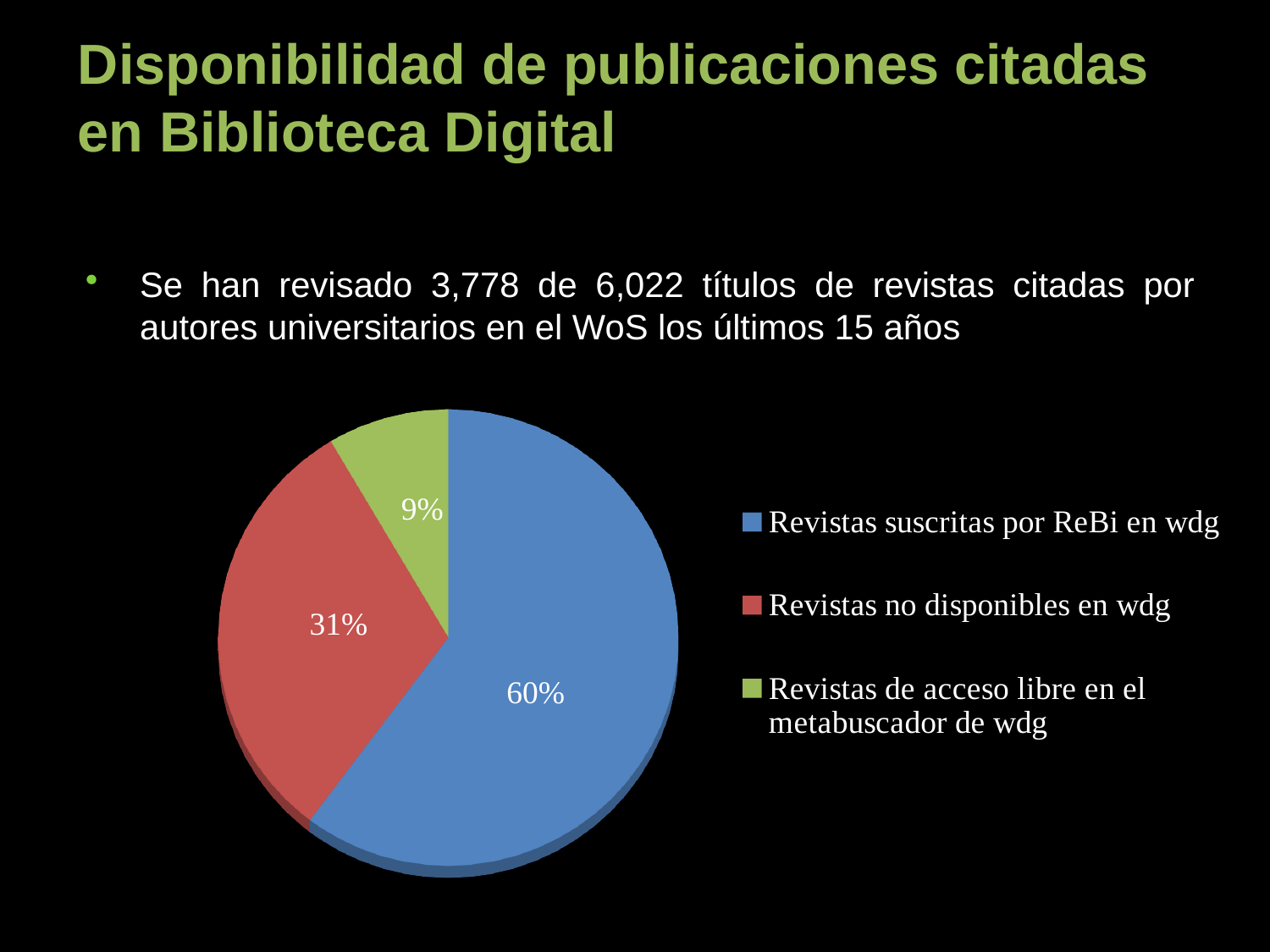
Which is larger: the slice for 'Revistas no disponibles en wdg' or the slice for 'Revistas de acceso libre en el metabuscador de wdg'? Revistas no disponibles en wdg What kind of chart is shown on the slide? Pie chart How many slices does the pie chart have? 3 Which category has the largest slice of the pie? Revistas suscritas por ReBi en wdg What share of the pie is 'Revistas no disponibles en wdg'? 31% What colour is the slice for 'Revistas no disponibles en wdg'? Red What is the difference in percentage points between 'Revistas no disponibles en wdg' and 'Revistas de acceso libre en el metabuscador de wdg'? 22 What share of the pie is 'Revistas suscritas por ReBi en wdg'? 60% What is the difference in percentage points between 'Revistas suscritas por ReBi en wdg' and 'Revistas no disponibles en wdg'? 29 How many entries does the legend list? 3 What share of the pie is 'Revistas de acceso libre en el metabuscador de wdg'? 9% Which category has the smallest slice of the pie? Revistas de acceso libre en el metabuscador de wdg